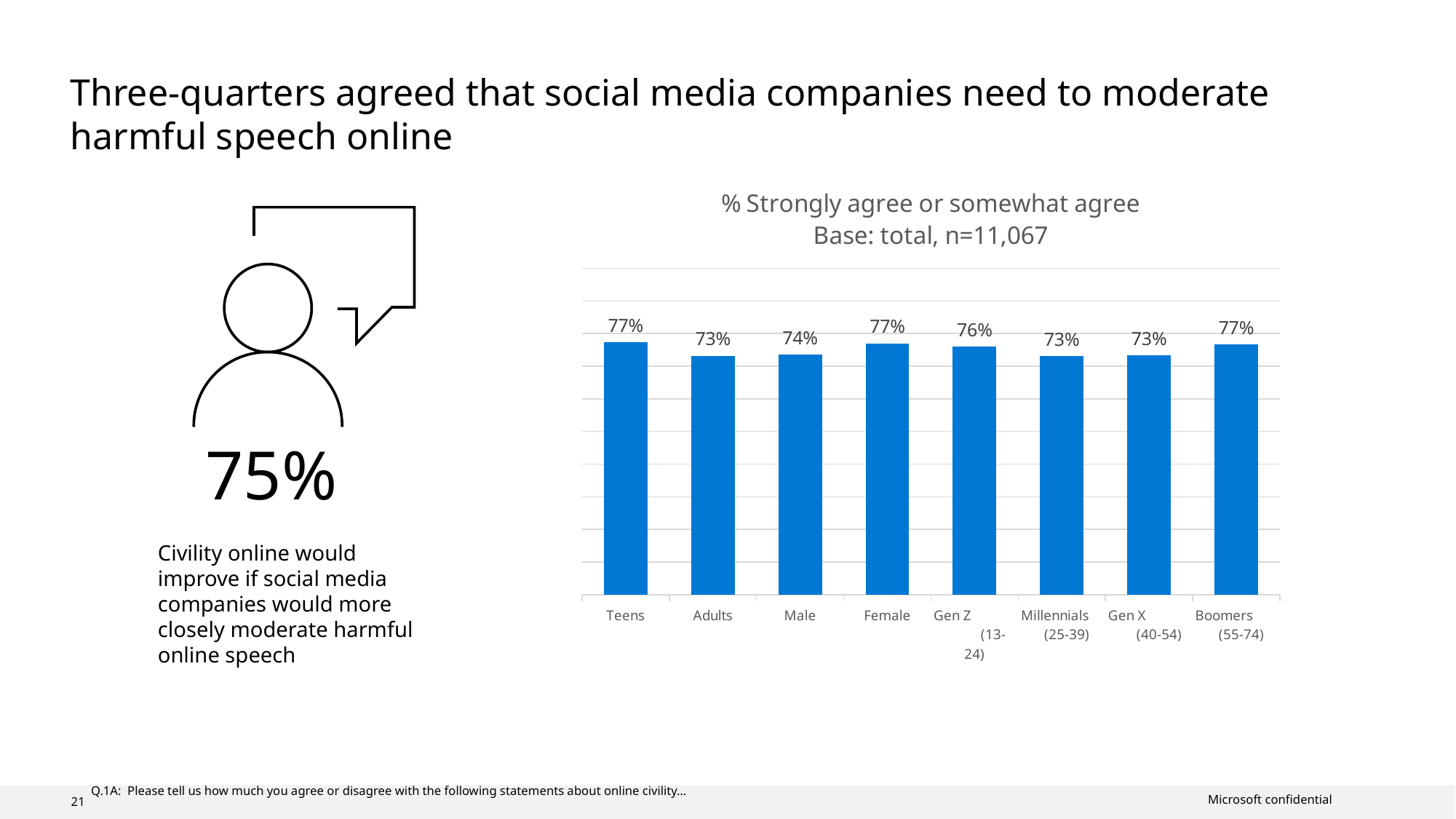
How many categories are shown in the chart? 8 What is the value for Boomers (55-74) in the chart? 77% What is the base sample size stated in the chart title? n=11,067 What is the value for Male in the chart? 74% What is the value for Female in the chart? 77% Which is larger, the value for Teens or the value for Adults? Teens What is the value for Gen Z (13-24) in the chart? 76% What is the value for Adults in the chart? 73% What is the value for Teens in the chart? 77% What is the value for Millennials (25-39) in the chart? 73% What is the difference between the value for Female and the value for Male? 3% What kind of chart is shown on the slide? Bar chart